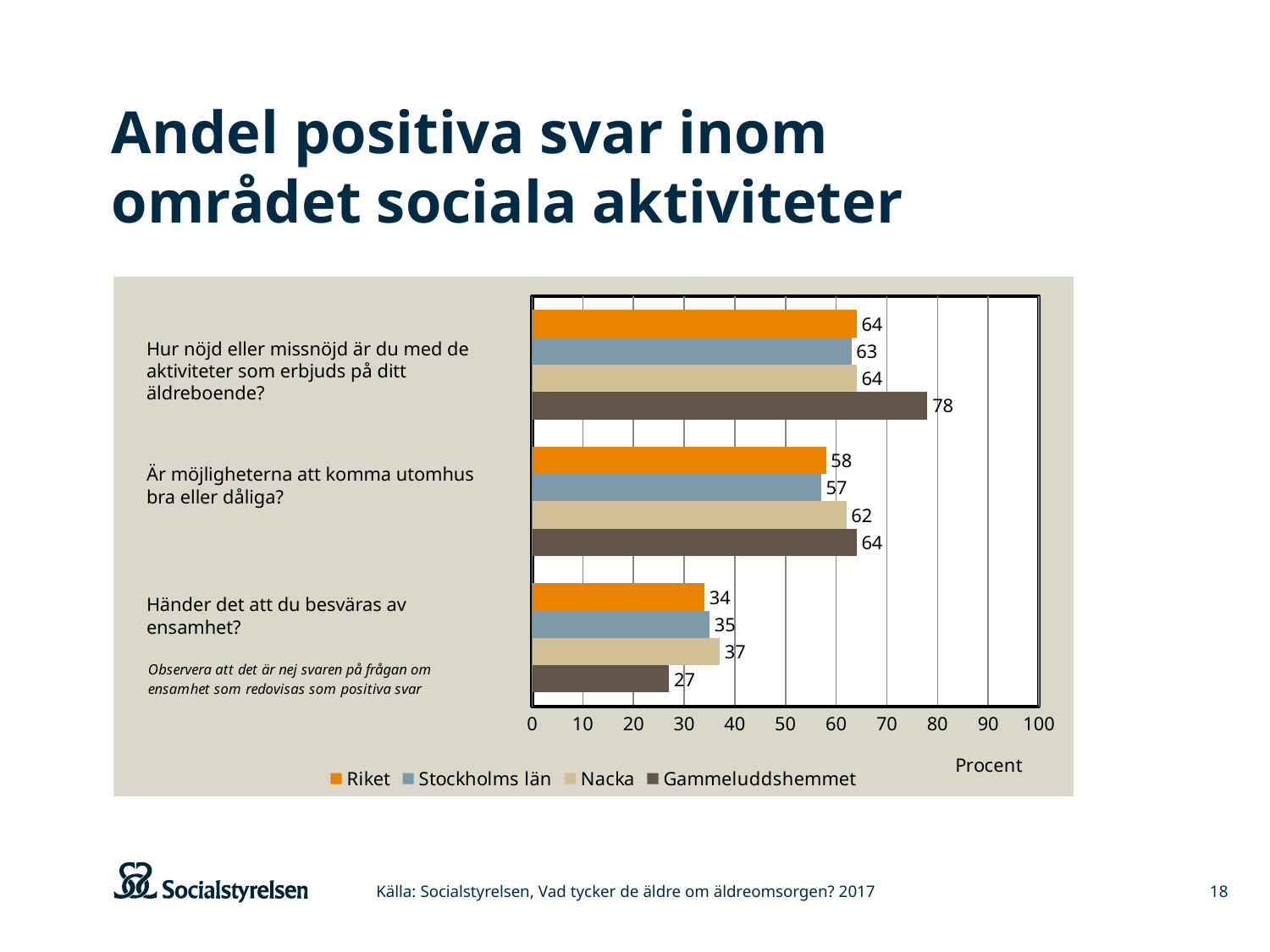
What is the value for Stockholms län on the question "Är möjligheterna att komma utomhus bra eller dåliga?"? 57 What is the value for Gammeluddshemmet on the question "Hur nöjd eller missnöjd är du med de aktiviteter som erbjuds på ditt äldreboende?"? 78 What unit label is shown on the horizontal axis of the chart? Procent What is the difference between Gammeluddshemmet and Riket on the question "Hur nöjd eller missnöjd är du med de aktiviteter som erbjuds på ditt äldreboende?"? 14 How many questions (categories) are shown on the chart? 3 How many series does the legend list? 4 What is the value for Riket on the question "Händer det att du besväras av ensamhet?"? 34 Which series has the lowest value for the question "Händer det att du besväras av ensamhet?"? Gammeluddshemmet What is the value for Nacka on the question "Är möjligheterna att komma utomhus bra eller dåliga?"? 62 Which is larger on the question "Händer det att du besväras av ensamhet?": Nacka or Gammeluddshemmet? Nacka What kind of chart is shown on the slide? Bar chart Which series has the highest value for the question "Hur nöjd eller missnöjd är du med de aktiviteter som erbjuds på ditt äldreboende?"? Gammeluddshemmet